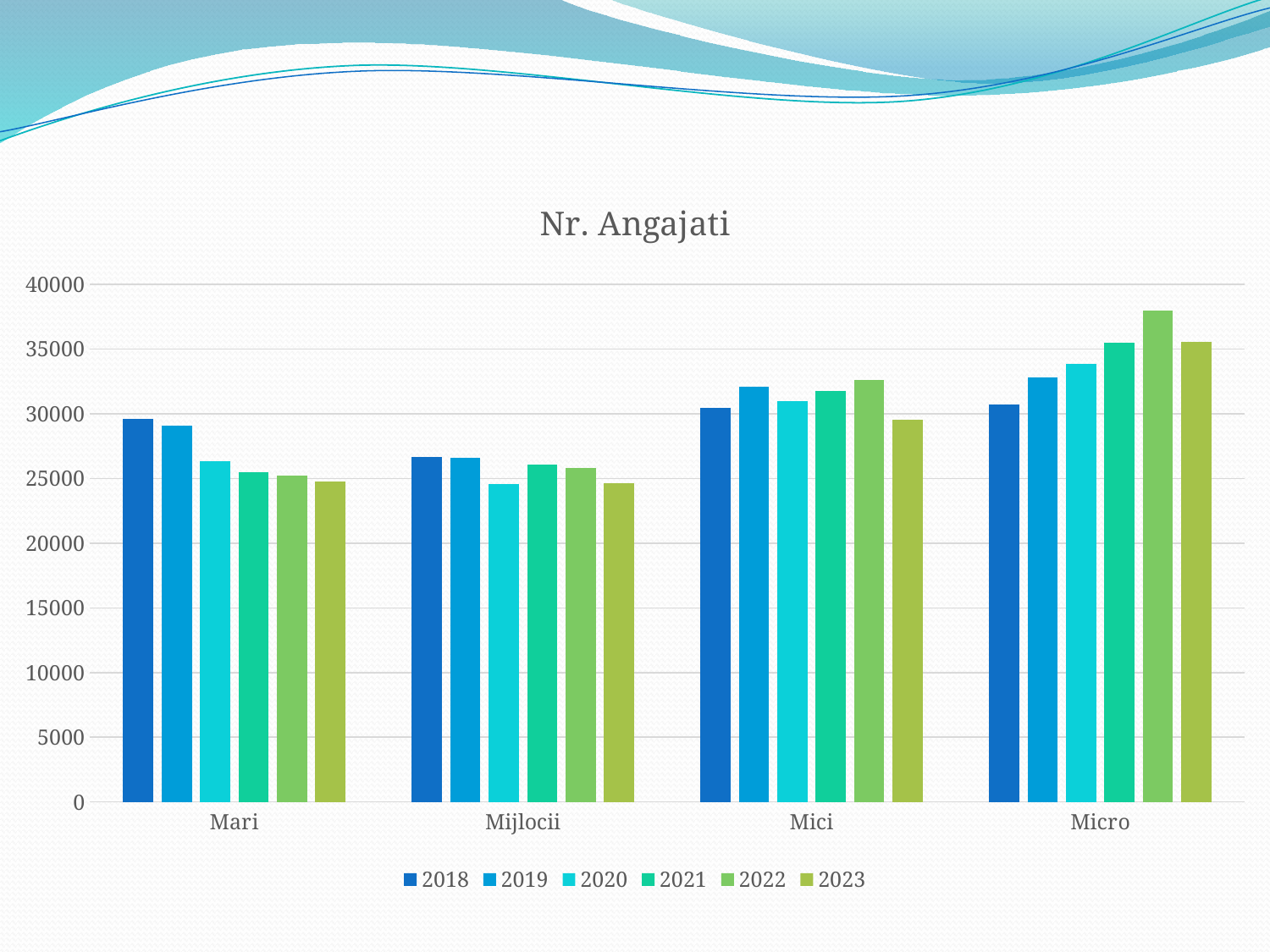
Which is larger, the 2023 value for Mici or the 2023 value for Micro? Micro Which category has the highest value for 2022? Micro Is the value for Mari in 2018 greater or less than 25000? greater Which category has the lowest value for 2018? Mijlocii What kind of chart is shown on the slide? bar chart Which is larger, the 2018 value for Mari or the 2018 value for Micro? Micro Is the value for Micro in 2022 greater or less than 35000? greater For the Mari category, do the values rise or fall from 2018 to 2023? fall What is the title of the chart? Nr. Angajati How many categories are shown on the x axis? 4 How many series does the legend list? 6